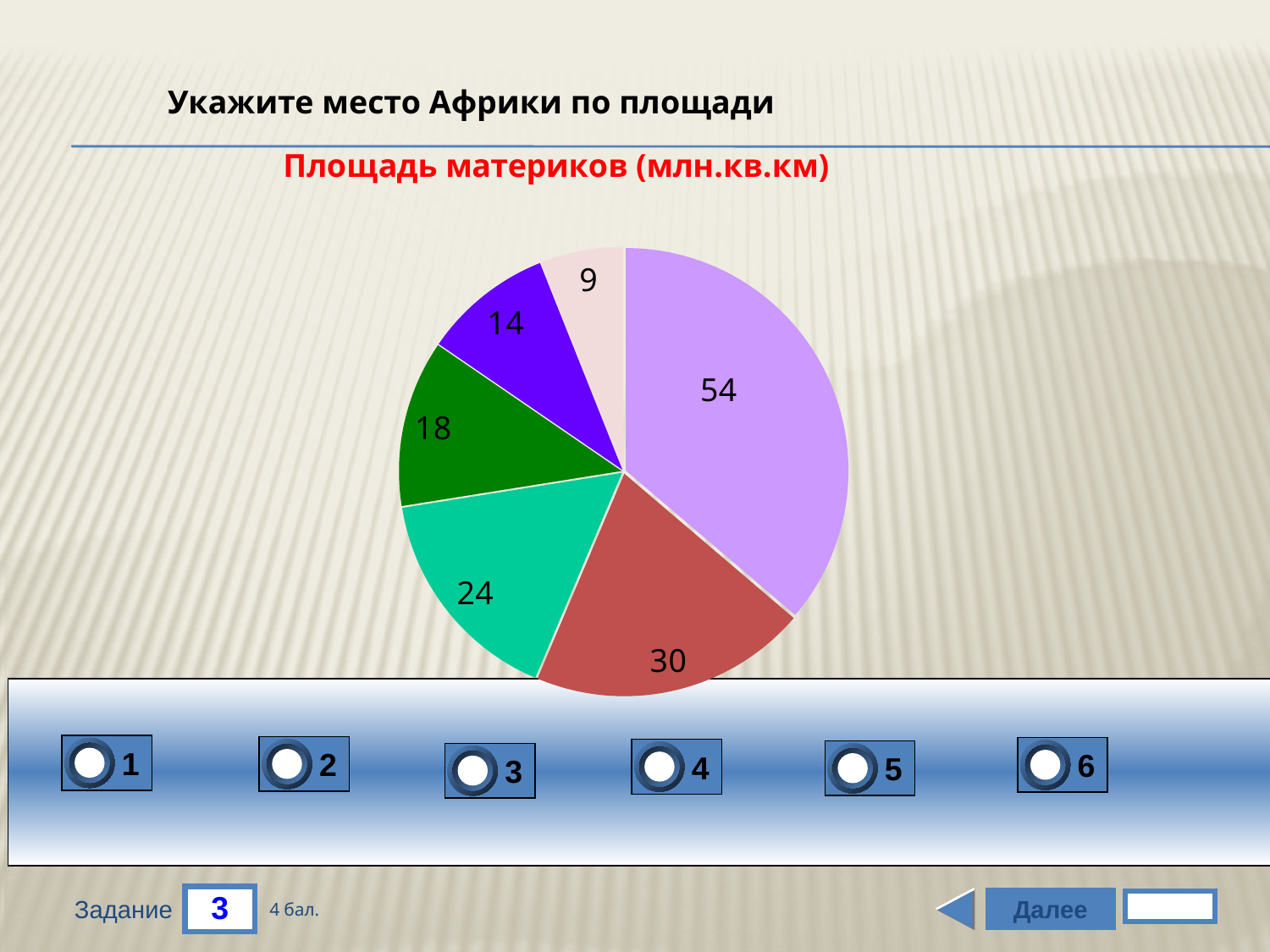
What kind of chart is shown on the slide? pie chart What is the title of the chart? Площадь материков (млн.кв.км) How many slices does the pie chart have? 6 What value is shown on the light purple (lilac) slice? 54 Which slice is larger, the teal slice or the dark green slice? the teal slice (24) What value is shown on the red slice? 30 What is the sum of all the slice values in the pie chart? 149 What value is shown on the dark green slice? 18 What value is shown on the dark blue-violet slice? 14 What is the difference between the largest slice (54) and the second largest slice (30)? 24 What is the value of the smallest slice of the pie chart? 9 What is the value of the largest slice of the pie chart? 54